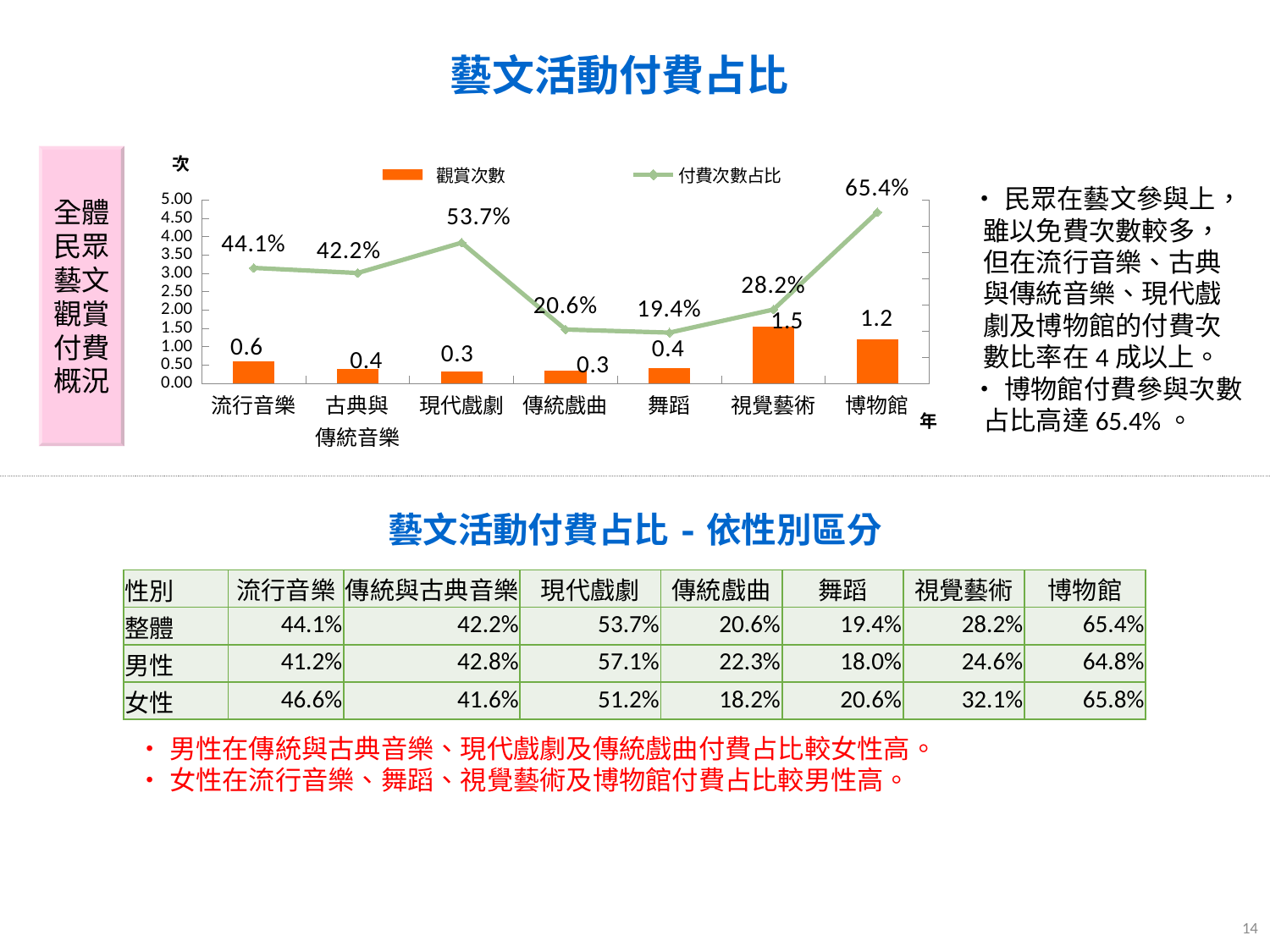
How many categories are shown on the x axis of the chart? 7 What is the 付費次數占比 value for 博物館? 65.4% What is the difference in 付費次數占比 between 博物館 and 現代戲劇? 11.7% What is the title of the chart? 藝文活動付費占比 What is the difference in 觀賞次數 between 視覺藝術 and 博物館? 0.3 What is the 付費次數占比 value for 傳統戲曲? 20.6% How many series does the chart legend list? 2 Which has a higher 付費次數占比, 流行音樂 or 古典與傳統音樂? 流行音樂 Which category has the highest 觀賞次數? 視覺藝術 Which category has the lowest 付費次數占比? 舞蹈 Which category has the highest 付費次數占比? 博物館 What is the 觀賞次數 value for 視覺藝術? 1.5